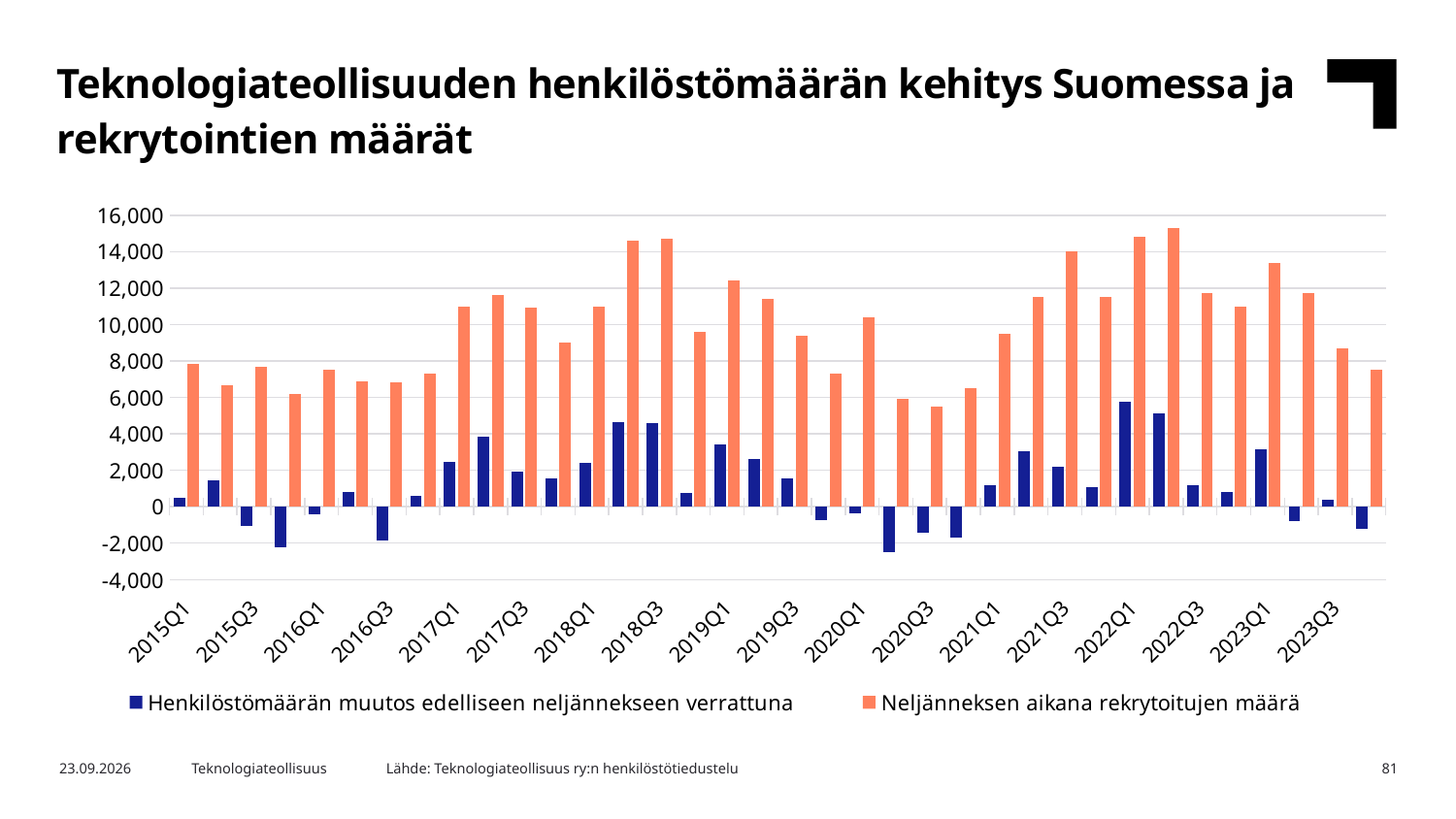
Which series is shown in orange according to the legend? Neljänneksen aikana rekrytoitujen määrä How many quarters are plotted on the x axis? 36 Which quarter has more recruits, 2018Q3 or 2019Q1? 2018Q3 Is the number of recruits in 2015Q4 greater or less than 8,000? less In which quarter is the number of recruits (Neljänneksen aikana rekrytoitujen määrä) highest? 2022Q2 How many series does the legend list? 2 In which quarter is the change in personnel (Henkilöstömäärän muutos edelliseen neljännekseen verrattuna) highest? 2022Q1 Do the numbers of recruits rise or fall from 2023Q1 to 2023Q4? fall What kind of chart is shown on the slide? bar chart Is the number of recruits in 2018Q2 greater or less than 14,000? greater Is the change in personnel in 2022Q1 greater or less than 4,000? greater